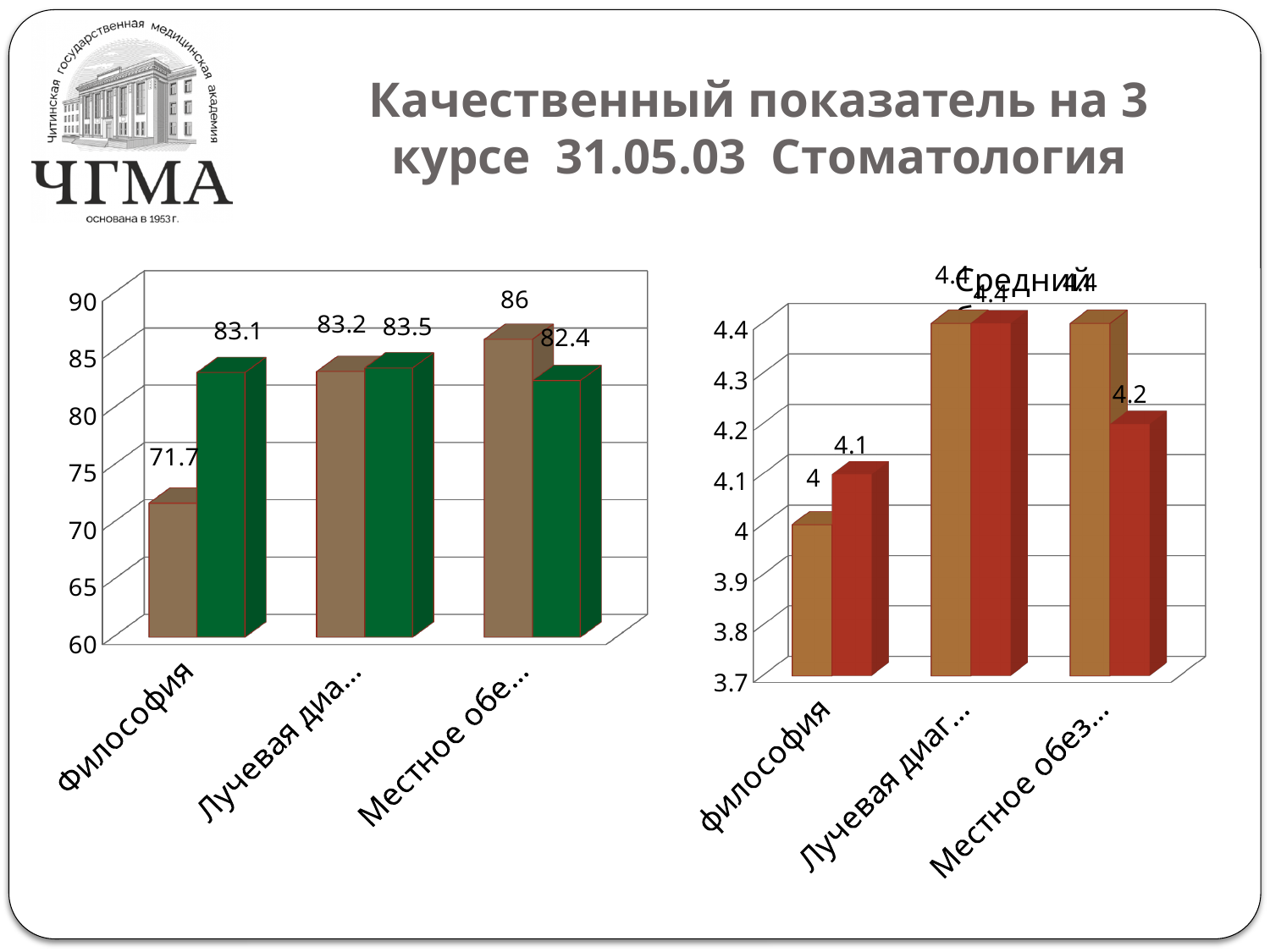
On the left chart, what is the value of the brown bar for the category whose label begins 'Местное'? 86 On the left chart, what is the value of the green bar for Философия? 83.1 On the left chart, what is the value of the brown bar for Философия? 71.7 On the left chart, which category has the lowest brown bar? Философия On the left chart, is the brown bar for Философия greater or less than 75? less On the right chart, which category has the lowest tan bar? философия On the left chart, what is the difference between the green and brown bars for Философия? 11.4 How many categories are shown on the left chart? 3 On the right chart, what is the value of the red bar for the category whose label begins 'Местное'? 4.2 What type of chart is the right chart? bar chart On the right chart, what is the value of the red bar for философия? 4.1 On the left chart, which category has the highest brown bar? Местное обе...